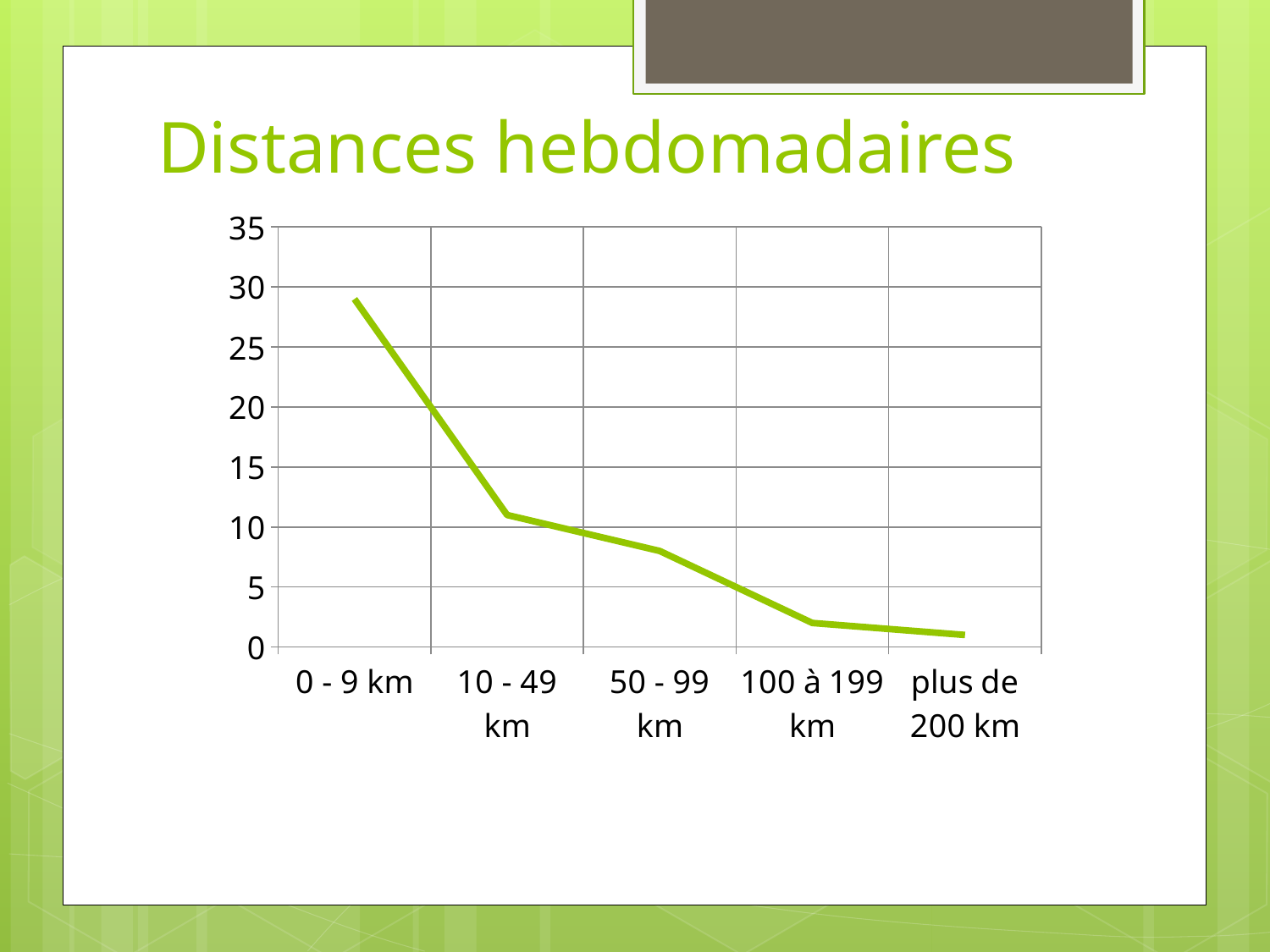
Which category has the lowest value? plus de 200 km Is the value for 100 à 199 km greater or less than 5? less Do the values rise or fall as you move from left to right along the x axis? fall What kind of chart is shown on the slide? line chart Is the value for 50 - 99 km greater or less than 5? greater What is the title of the chart? Distances hebdomadaires Is the value for 10 - 49 km greater or less than 15? less How many categories are plotted along the x axis? 5 Which is larger, the value for 10 - 49 km or the value for 50 - 99 km? 10 - 49 km What is the highest value shown on the y axis? 35 Which category has the highest value? 0 - 9 km